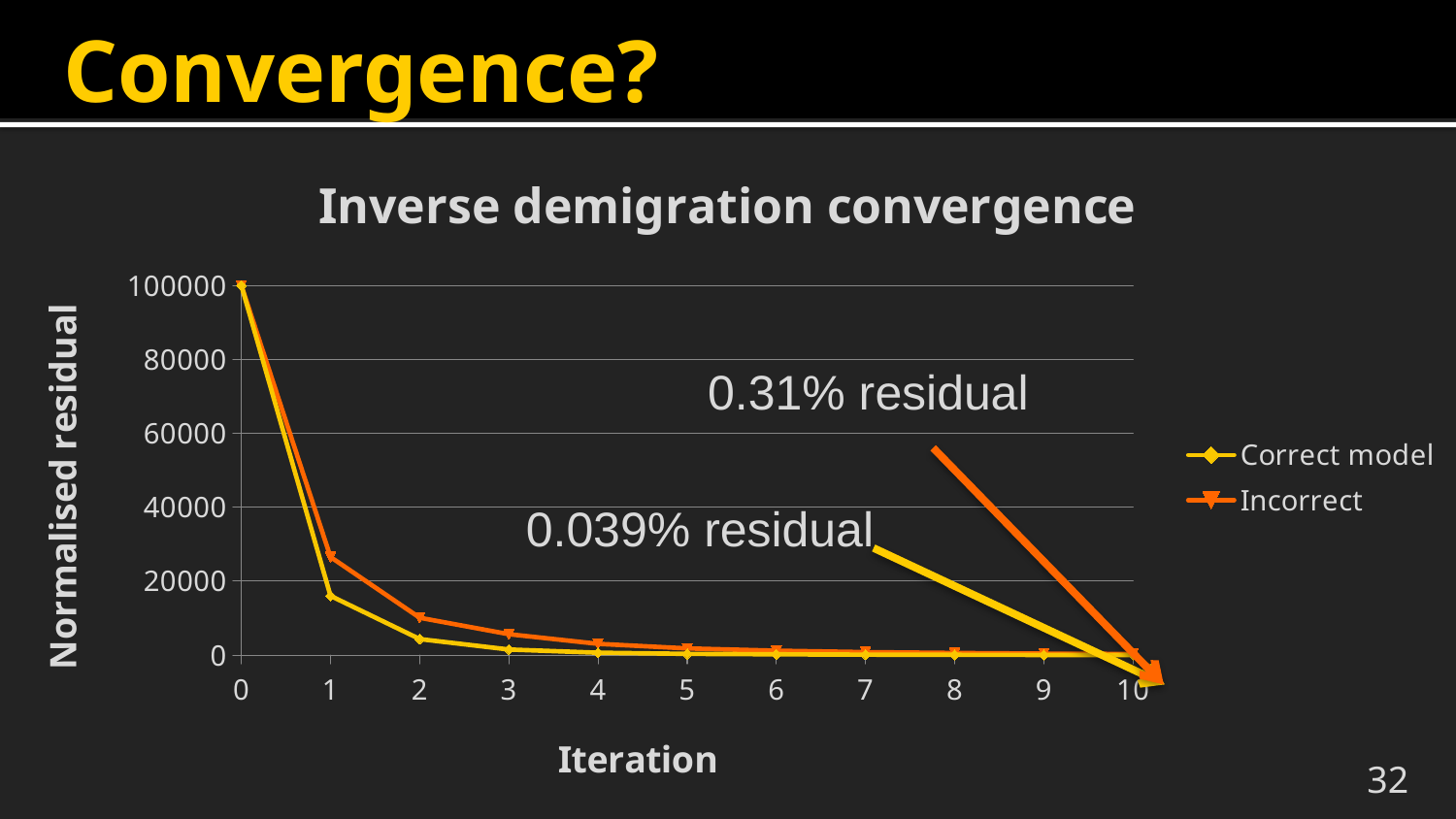
At iteration 1, which series has the larger value, Correct model or Incorrect? Incorrect What is the title of the chart? Inverse demigration convergence How many series does the legend list? 2 What is the label of the x axis? Iteration How many iteration points are plotted along the x axis for each series? 11 According to the annotation, what residual does the Correct model series reach at the final iteration? 0.039% residual Is the value for the Correct model series at iteration 1 greater or less than 20000? less What type of chart is shown on the slide? line chart What is the value of the Correct model series at iteration 0? 100000 Is the value for the Incorrect series at iteration 1 greater or less than 20000? greater Do the values of the Correct model series rise or fall as the iteration increases? fall What is the value of the Incorrect series at iteration 0? 100000